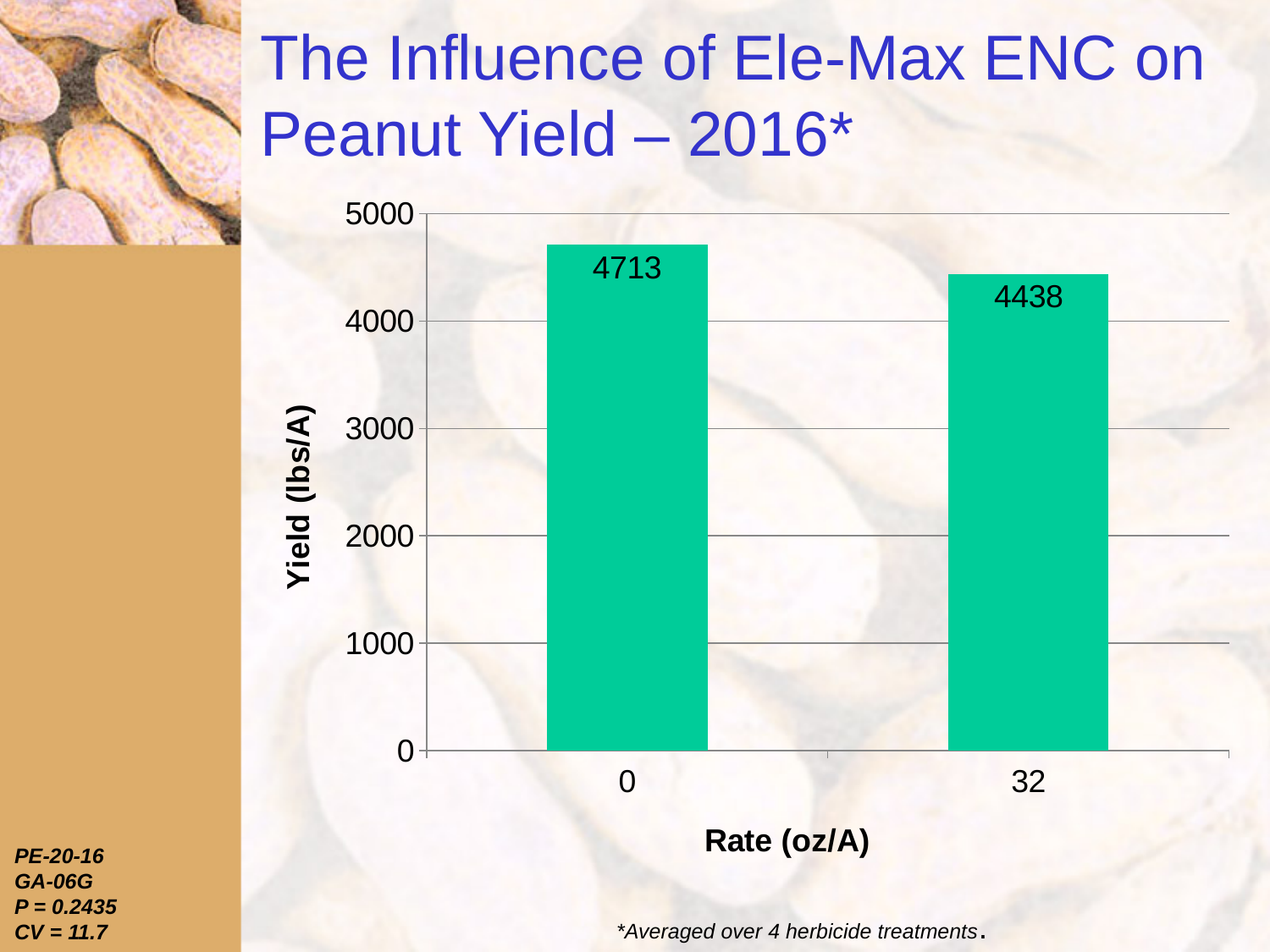
Is the yield for the 32 oz/A rate greater or less than 4000? greater What is the difference in yield between the 0 and 32 oz/A rates? 275 What is the label of the x axis? Rate (oz/A) Which rate has the lowest yield? 32 How many rate categories are shown on the chart? 2 What kind of chart is shown on the slide? bar chart Does the yield rise or fall as the rate increases from 0 to 32 oz/A? fall What is the yield for a rate of 0 oz/A? 4713 Which rate has the larger yield, 0 or 32 oz/A? 0 What is the label of the y axis? Yield (lbs/A) What is the yield for a rate of 32 oz/A? 4438 Which rate has the highest yield? 0